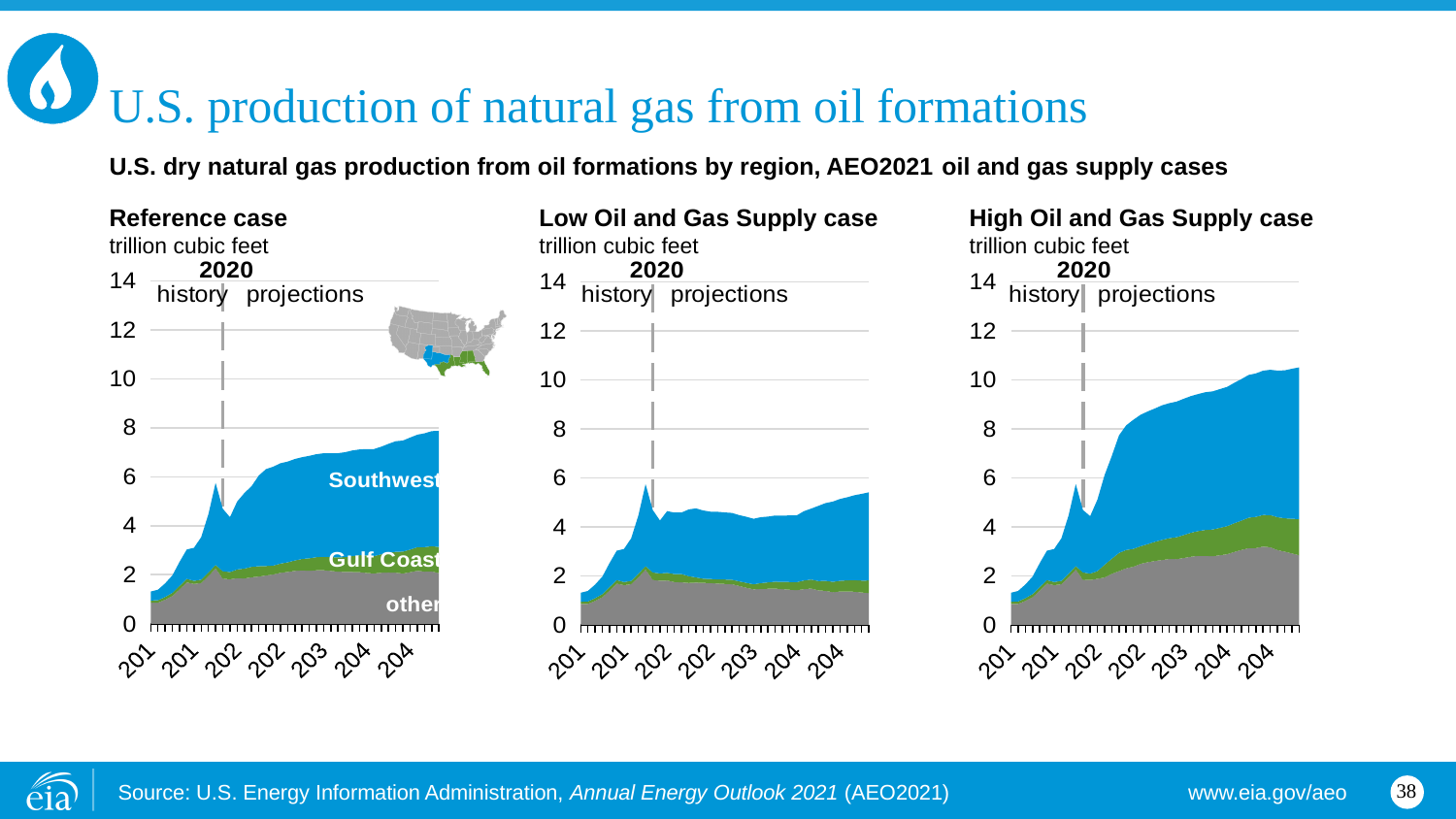
Which chart shows the highest total production at the end of the projection period? High Oil and Gas Supply case In the High Oil and Gas Supply case chart, is the total production at the end of the projection period greater or less than 10? greater In the Reference case chart, is the total production at the end of the projection period greater or less than 6? greater What kind of chart is the Reference case chart? stacked area chart In the Reference case chart, is the total production in 2020 greater or less than 8? less Which region is the top layer in the Reference case chart? Southwest Which chart shows the lowest total production at the end of the projection period? Low Oil and Gas Supply case In the High Oil and Gas Supply case chart, does total production generally rise or fall over the projection period? rise Is the total production at the end of the projection period larger in the Reference case chart or the Low Oil and Gas Supply case chart? Reference case How many regions are labeled in the Reference case chart? 3 What unit is shown on the y axis of the three charts? trillion cubic feet